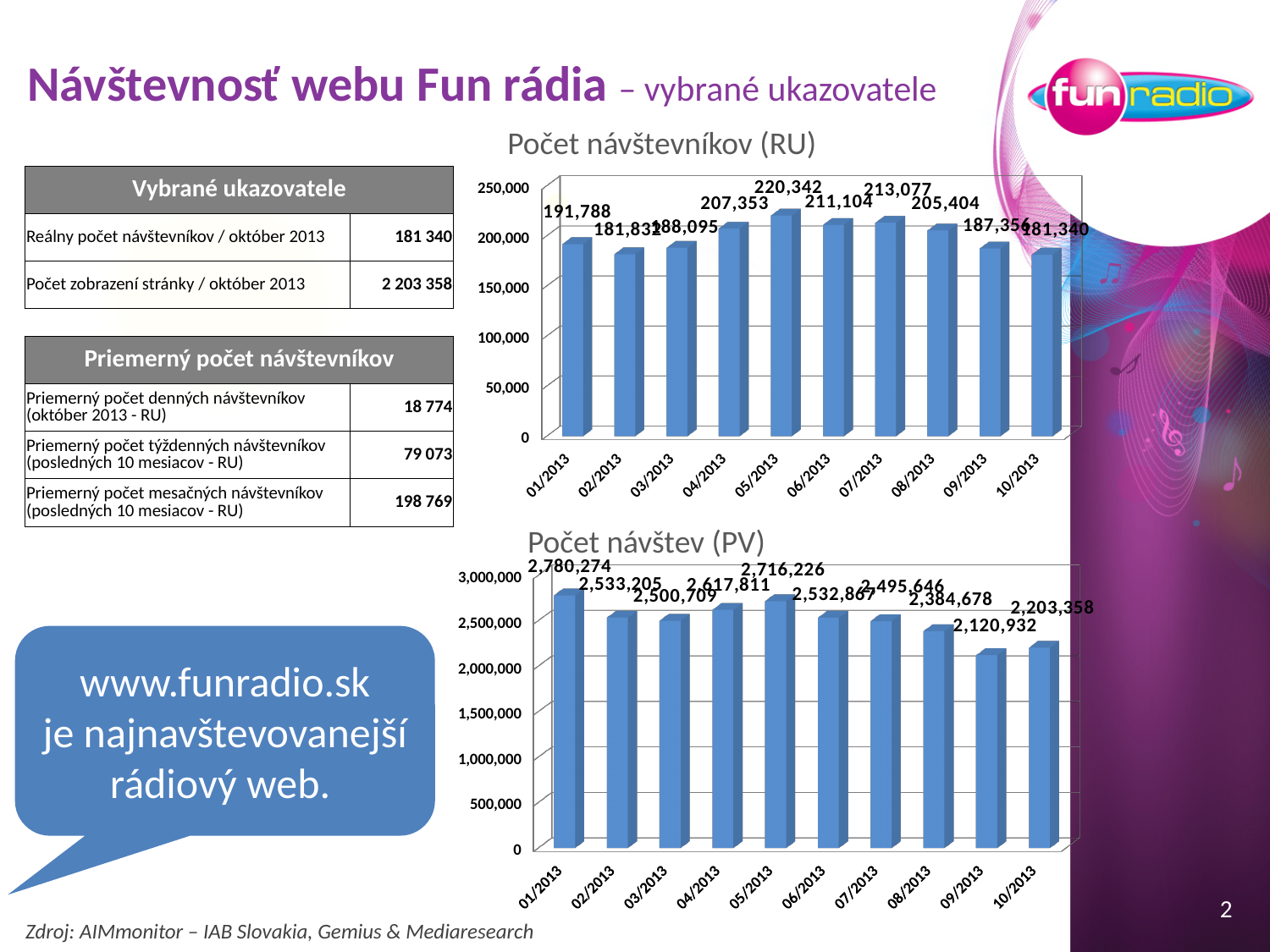
How many months are shown in the 'Počet návštevníkov (RU)' chart? 10 In the 'Počet návštev (PV)' chart, which month has the lowest value? 09/2013 In the 'Počet návštev (PV)' chart, which month has the highest value? 01/2013 In the 'Počet návštev (PV)' chart, what is the value for 10/2013? 2,203,358 In the 'Počet návštevníkov (RU)' chart, what is the value for 01/2013? 191,788 In the 'Počet návštevníkov (RU)' chart, what is the value for 05/2013? 220,342 In the 'Počet návštev (PV)' chart, what is the difference between the values for 01/2013 and 10/2013? 576,916 In the 'Počet návštevníkov (RU)' chart, what is the difference between the values for 05/2013 and 01/2013? 28,554 In the 'Počet návštevníkov (RU)' chart, which month has the highest value? 05/2013 In the 'Počet návštevníkov (RU)' chart, is the value for 04/2013 greater or less than 200,000? greater What kind of chart is the 'Počet návštev (PV)' chart? bar chart In the 'Počet návštev (PV)' chart, which is larger, the value for 04/2013 or 06/2013? 04/2013